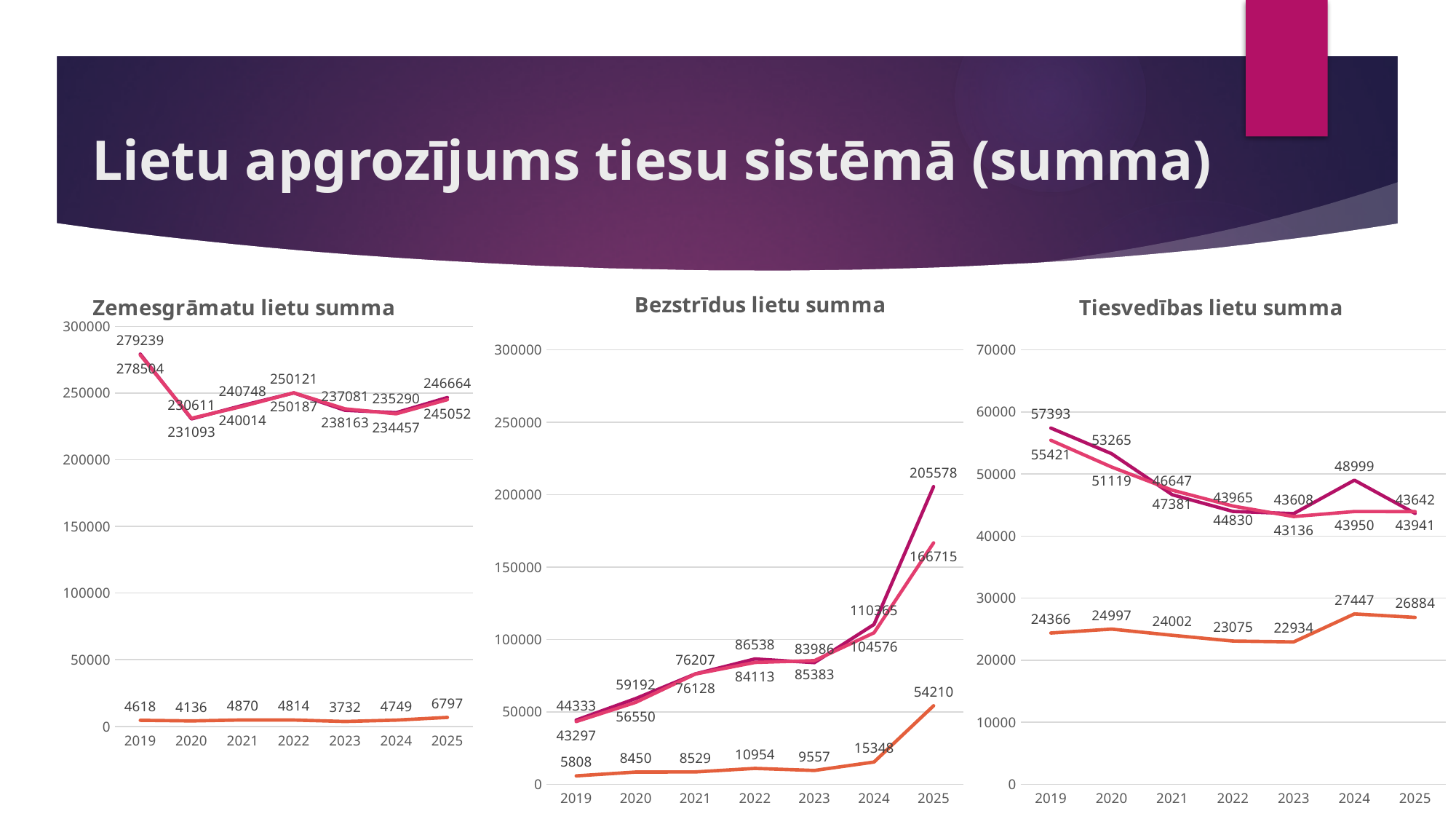
In the "Tiesvedības lietu summa" chart, how many lines are plotted? 3 In the "Tiesvedības lietu summa" chart, what is the highest value labelled on the chart? 57393 In the "Bezstrīdus lietu summa" chart, what is the difference between the two highest labelled values for 2025 (205578 and 166715)? 38863 In the "Tiesvedības lietu summa" chart, what is the value of the orange line in 2024? 27447 In the "Tiesvedības lietu summa" chart, is the value of the orange line in 2023 greater or less than 30000? less In the "Bezstrīdus lietu summa" chart, how many years are shown on the x axis? 7 In the "Zemesgrāmatu lietu summa" chart, what is the lowest value labelled on the chart? 3732 What kind of chart is "Zemesgrāmatu lietu summa"? Line chart In the "Zemesgrāmatu lietu summa" chart, what is the value of the orange line in 2025? 6797 In the "Bezstrīdus lietu summa" chart, what is the highest value labelled for 2025? 205578 In the "Bezstrīdus lietu summa" chart, do the values of the top lines rise or fall from 2019 to 2025? Rise What is the title of the middle chart on the slide? Bezstrīdus lietu summa